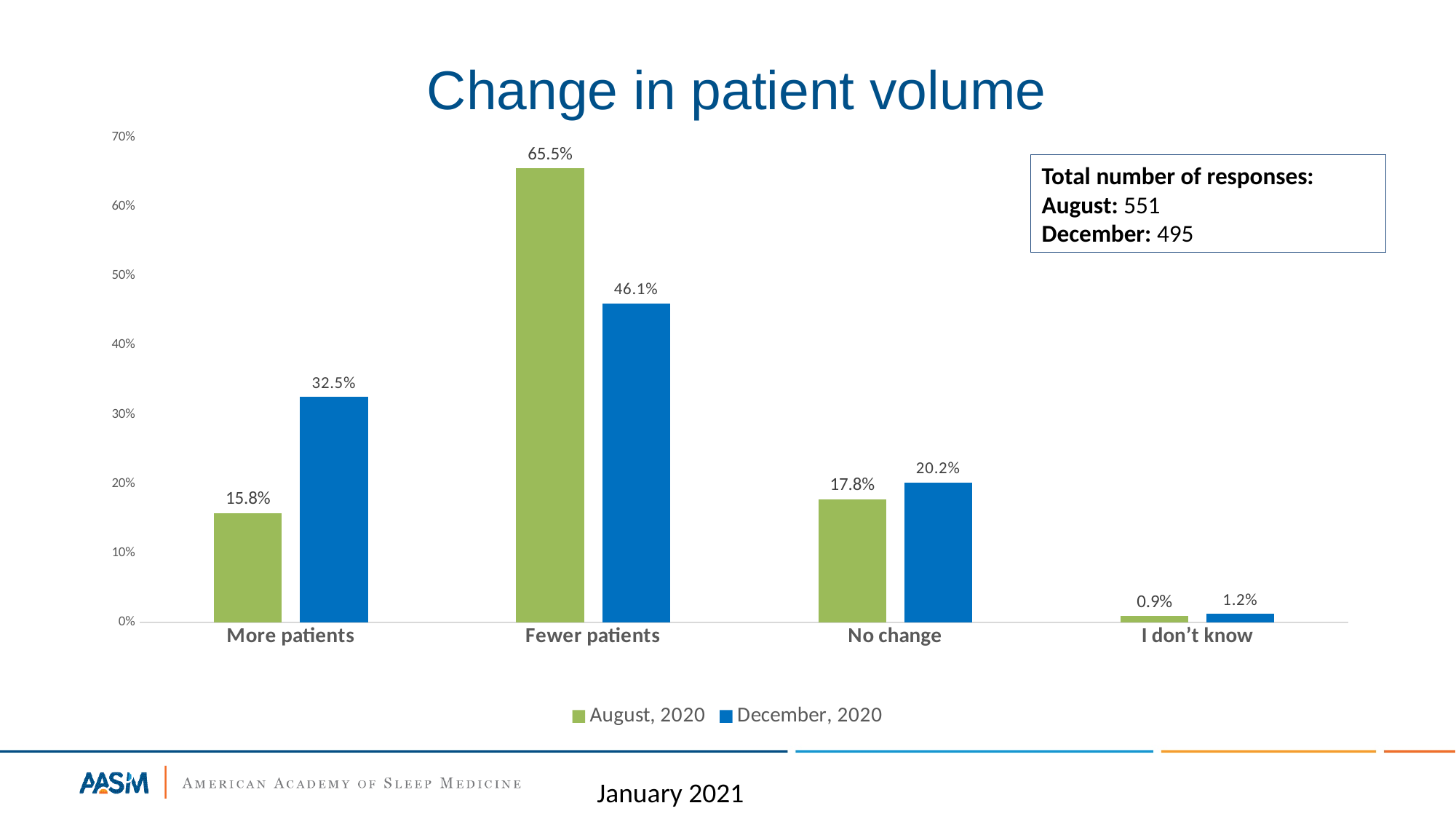
What is the value for "Fewer patients" in the August, 2020 series? 65.5% What is the value for "No change" in the August, 2020 series? 17.8% What kind of chart is shown on the slide? Bar chart Which category has the lowest value in the August, 2020 series? I don't know What is the value for "More patients" in the December, 2020 series? 32.5% Which category has the highest value in the December, 2020 series? Fewer patients What is the title of the chart? Change in patient volume What is the difference between the December, 2020 and August, 2020 values for "More patients"? 16.7% What is the difference between the August, 2020 and December, 2020 values for "Fewer patients"? 19.4% Which is larger for "No change": the August, 2020 value or the December, 2020 value? December, 2020 How many categories are shown on the x axis? 4 How many series does the legend list? 2